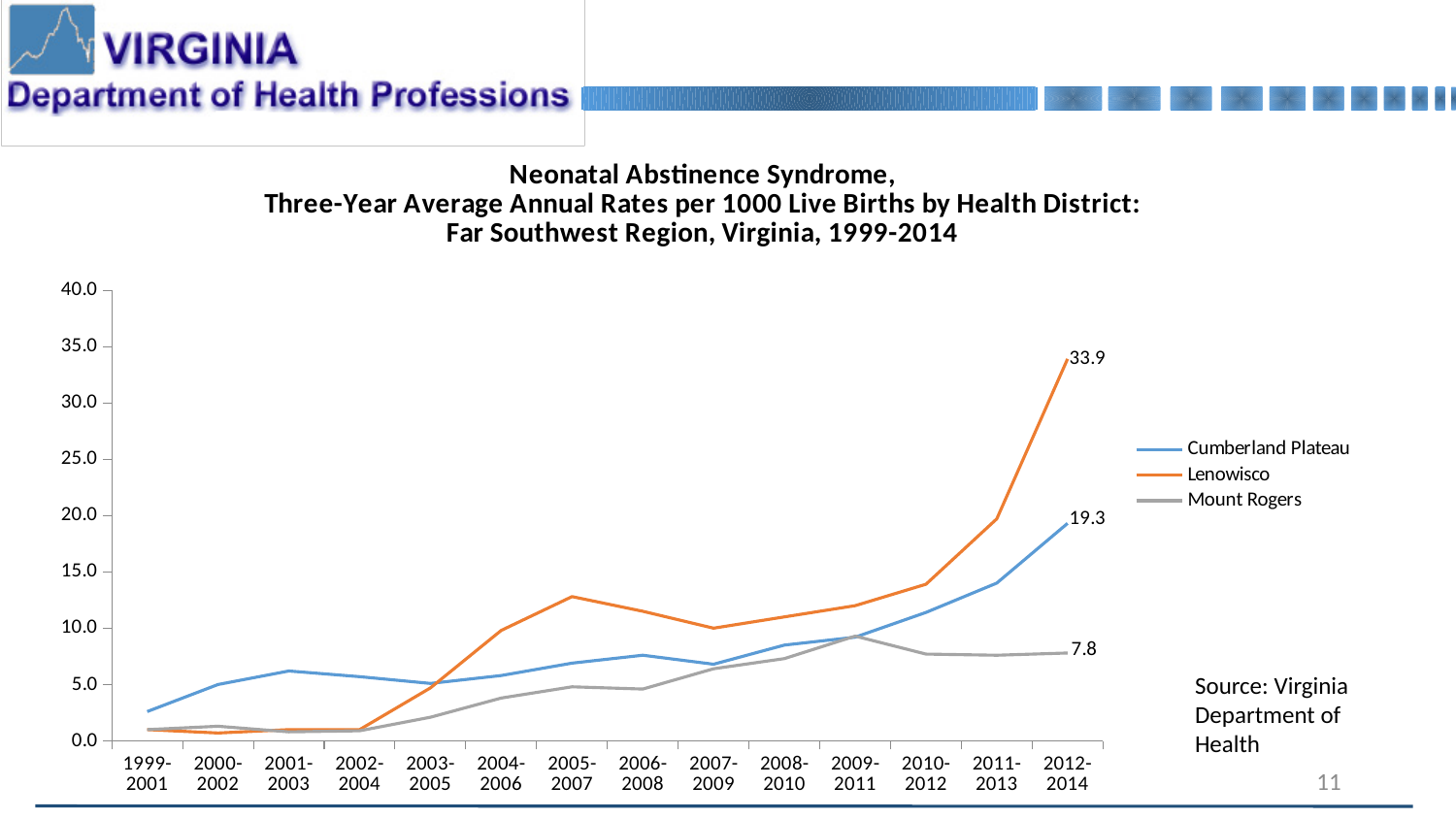
Which health district has the lowest rate in 2012-2014? Mount Rogers Is the value for Lenowisco in 2005-2007 greater or less than 10.0? greater What is the rate for Mount Rogers in 2012-2014? 7.8 What is the difference between the Cumberland Plateau and Mount Rogers rates in 2012-2014? 11.5 What is the rate for Lenowisco in 2012-2014? 33.9 Which health district has the highest rate in 2012-2014? Lenowisco How many series does the legend list? 3 What kind of chart is shown on the slide? line chart What is the difference between the Lenowisco and Cumberland Plateau rates in 2012-2014? 14.6 Which is larger in 2001-2003, the Cumberland Plateau rate or the Lenowisco rate? Cumberland Plateau What is the rate for Cumberland Plateau in 2012-2014? 19.3 How many three-year periods are shown on the x axis? 14